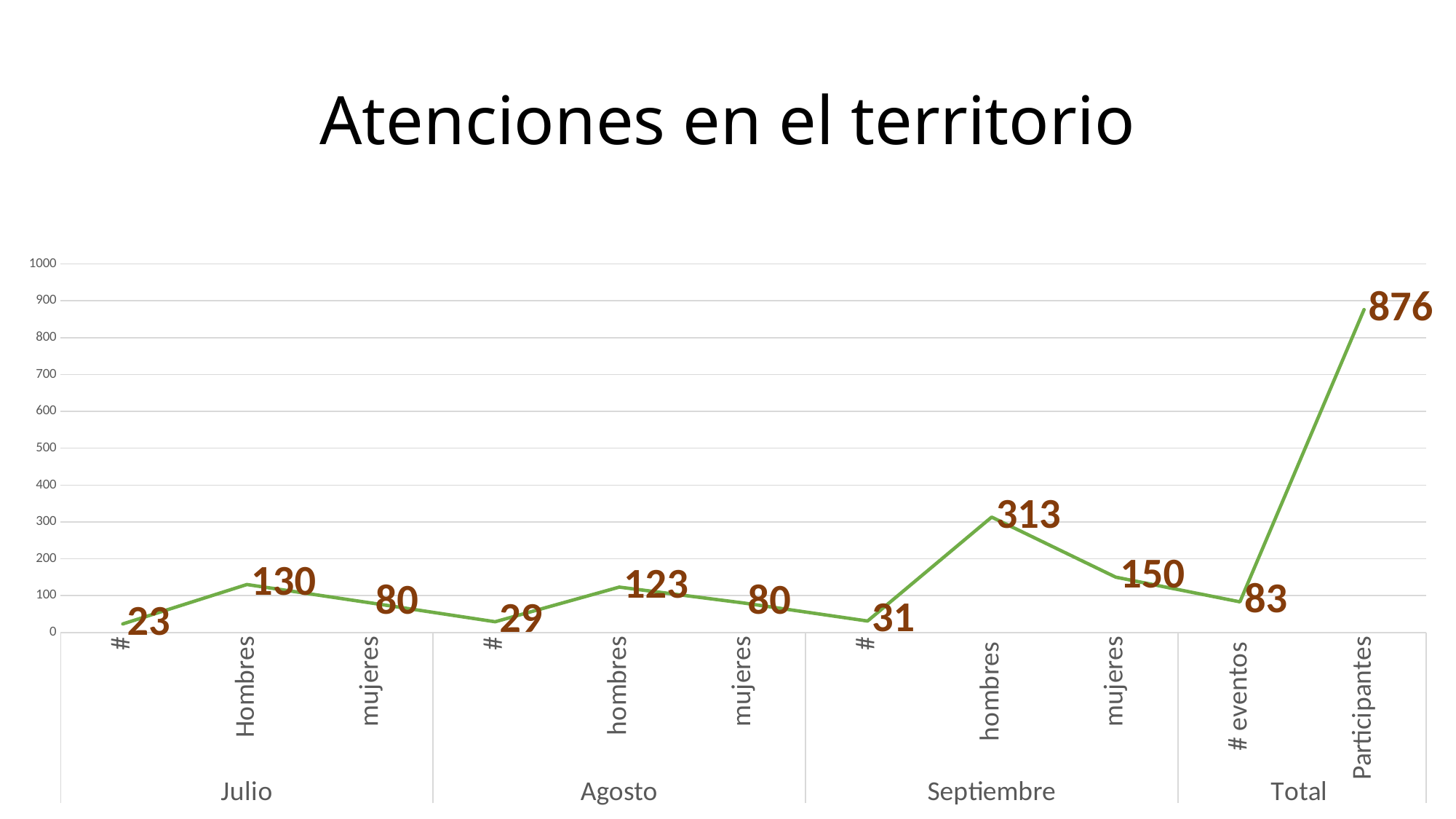
Which is larger, Hombres in Julio or hombres in Agosto? Hombres in Julio How many month groups (including Total) are shown on the x axis? 4 What is the value for # eventos under Total? 83 How many data points are plotted on the line? 11 What is the value for Participantes under Total? 876 What is the value for hombres in Septiembre? 313 What is the difference between hombres and mujeres in Septiembre? 163 What is the title of the chart? Atenciones en el territorio What type of chart is shown on the slide? line chart Which point on the line has the lowest value? # in Julio What is the value for Hombres in Julio? 130 Which point on the line has the highest value? Participantes